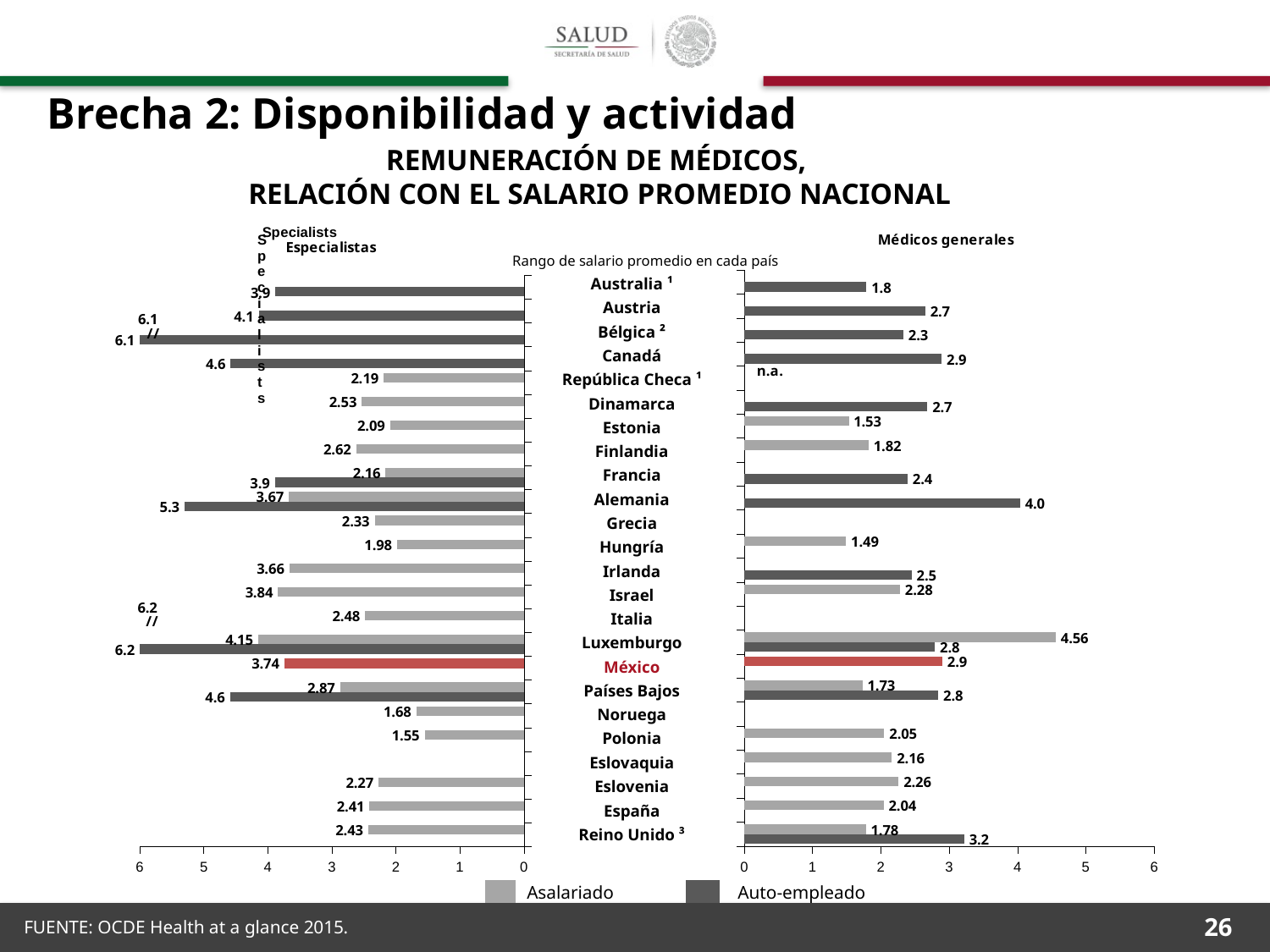
What kind of chart is used on this slide? Bar chart In the Especialistas chart, which is larger: the Auto-empleado value for Alemania or for Francia? Alemania In the Médicos generales chart, what is the Auto-empleado value for Reino Unido? 3.2 In the Médicos generales chart, which country has the lowest labelled value? Hungría In the Médicos generales chart, what is the difference between the Asalariado and Auto-empleado values for Luxemburgo? 1.76 In the Especialistas chart, which country has the lowest labelled value? Polonia In the Especialistas chart, what is the value shown for México? 3.74 In the Médicos generales chart, what is the Asalariado value for Luxemburgo? 4.56 In the Médicos generales chart, what is shown for República Checa? n.a. In the Médicos generales chart, what is the Auto-empleado value for Alemania? 4.0 How many series does the legend list? 2 In the Médicos generales chart, what is the value shown for México? 2.9